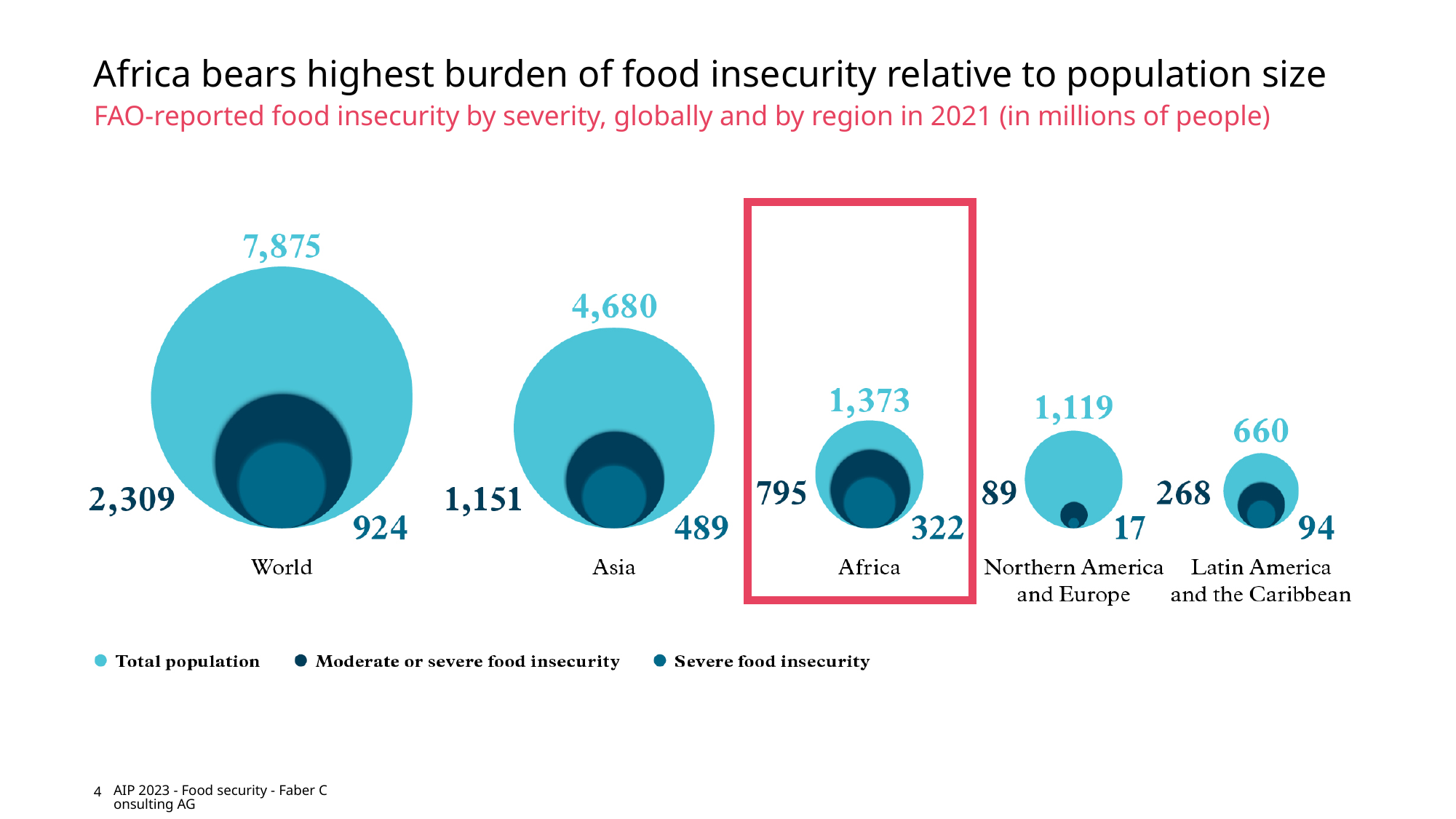
What is the value for severe food insecurity in Northern America and Europe? 17 What is the value for moderate or severe food insecurity in Asia? 1,151 Which region has the lowest value for severe food insecurity? Northern America and Europe What is the value for moderate or severe food insecurity for the World? 2,309 What is the difference between the total population of Africa and that of Northern America and Europe? 254 Which region (excluding World) has the highest total population? Asia How many categories (regions including World) are shown in the chart? 5 How many series does the legend list? 3 What kind of chart is shown on the slide? Bubble chart Which category is highlighted with a red box on the slide? Africa Which is larger: severe food insecurity in Africa or in Latin America and the Caribbean? Africa What is the total population shown for Africa? 1,373